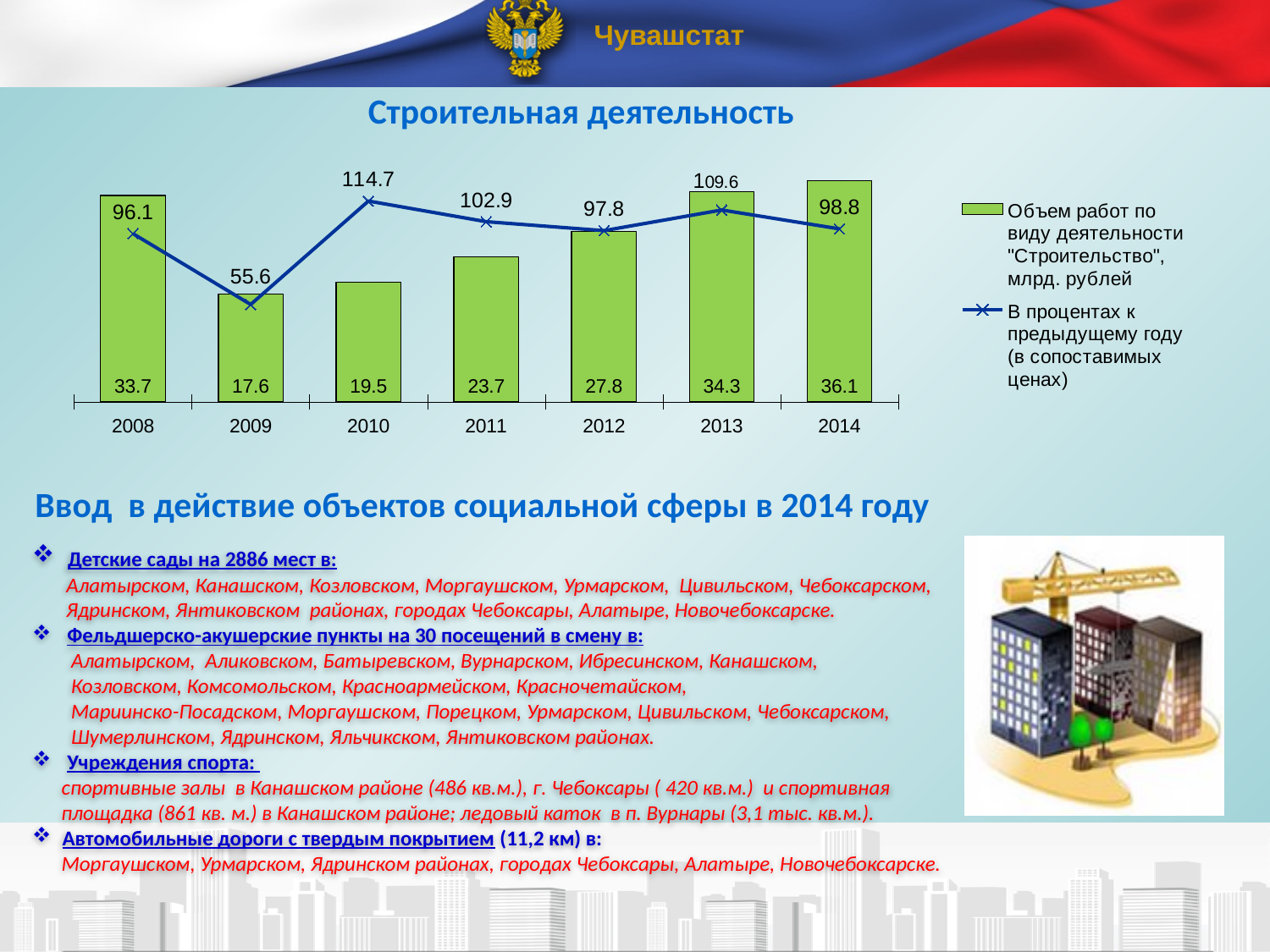
Which year has the larger volume of construction work, 2011 or 2012? 2012 Do the bar values for volume of construction work rise or fall from 2009 to 2014? Rise What is the volume of construction work (млрд. рублей) shown for 2009? 17.6 How many years are shown on the x axis of the chart? 7 Which year has the lowest value of the line series 'В процентах к предыдущему году'? 2009 What is the difference between the volume of construction work in 2014 and in 2008? 2.4 What is the value of the line series 'В процентах к предыдущему году' for 2010? 114.7 What is the volume of construction work (млрд. рублей) shown for 2014? 36.1 How many series does the chart legend list? 2 What is the title of the chart section on the slide? Строительная деятельность What kind of chart is used to show the volume of construction work (млрд. рублей)? Bar chart Which year has the highest volume of construction work (bar series)? 2014